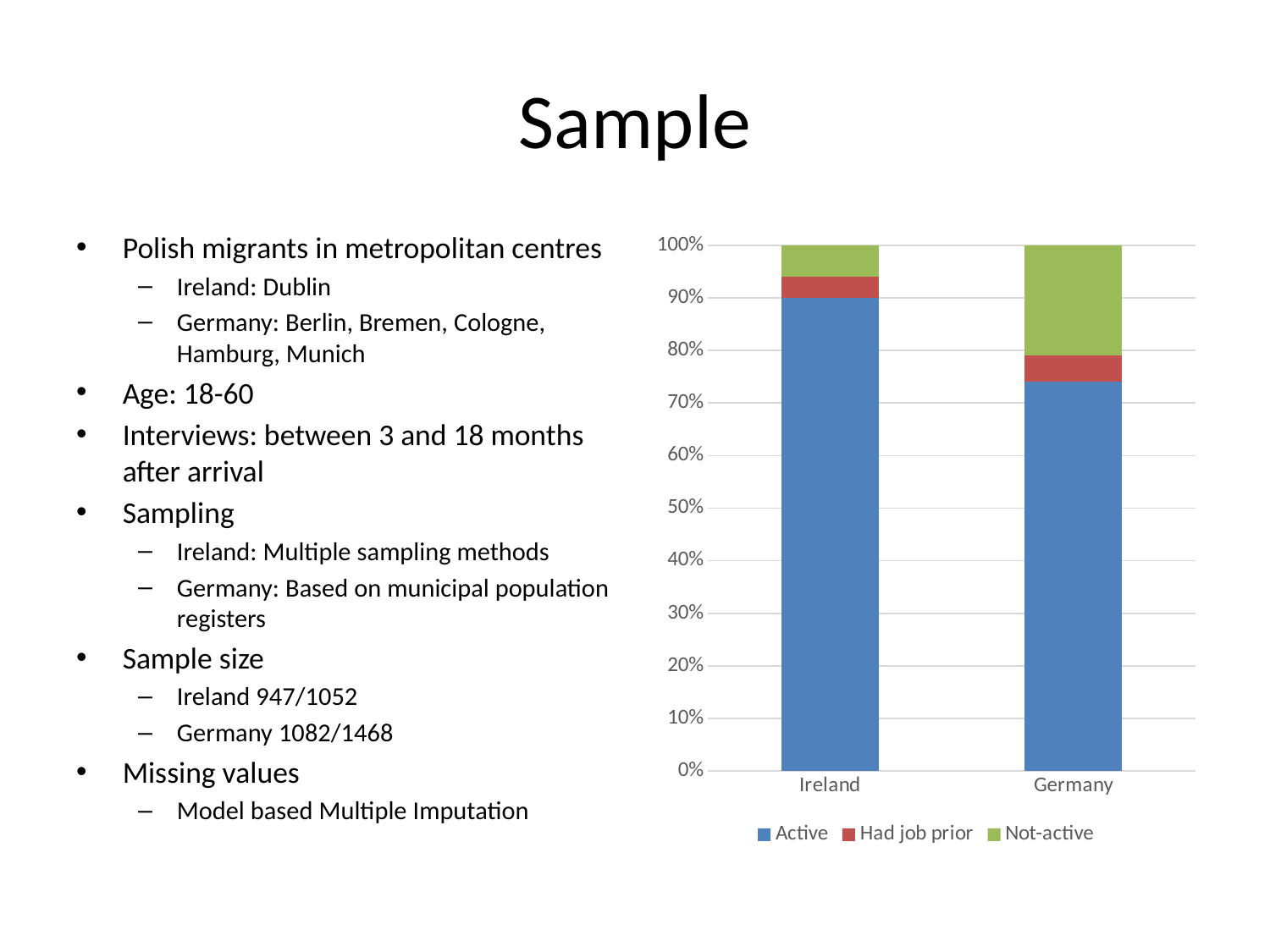
Is the Active value for Germany greater or less than 80%? less What are the series names listed in the chart's legend? Active, Had job prior, Not-active What colour represents the Active series in the chart? Blue How many series does the chart's legend list? 3 What kind of chart is shown on the slide? Stacked bar chart Which category has the larger Not-active share, Ireland or Germany? Germany Is the Active value for Ireland greater or less than 80%? greater What is the total height of the stacked bar for Ireland? 100% How many categories are shown on the x axis of the chart? 2 Which category has the larger Active share, Ireland or Germany? Ireland Is the Not-active value for Ireland greater or less than 10%? less